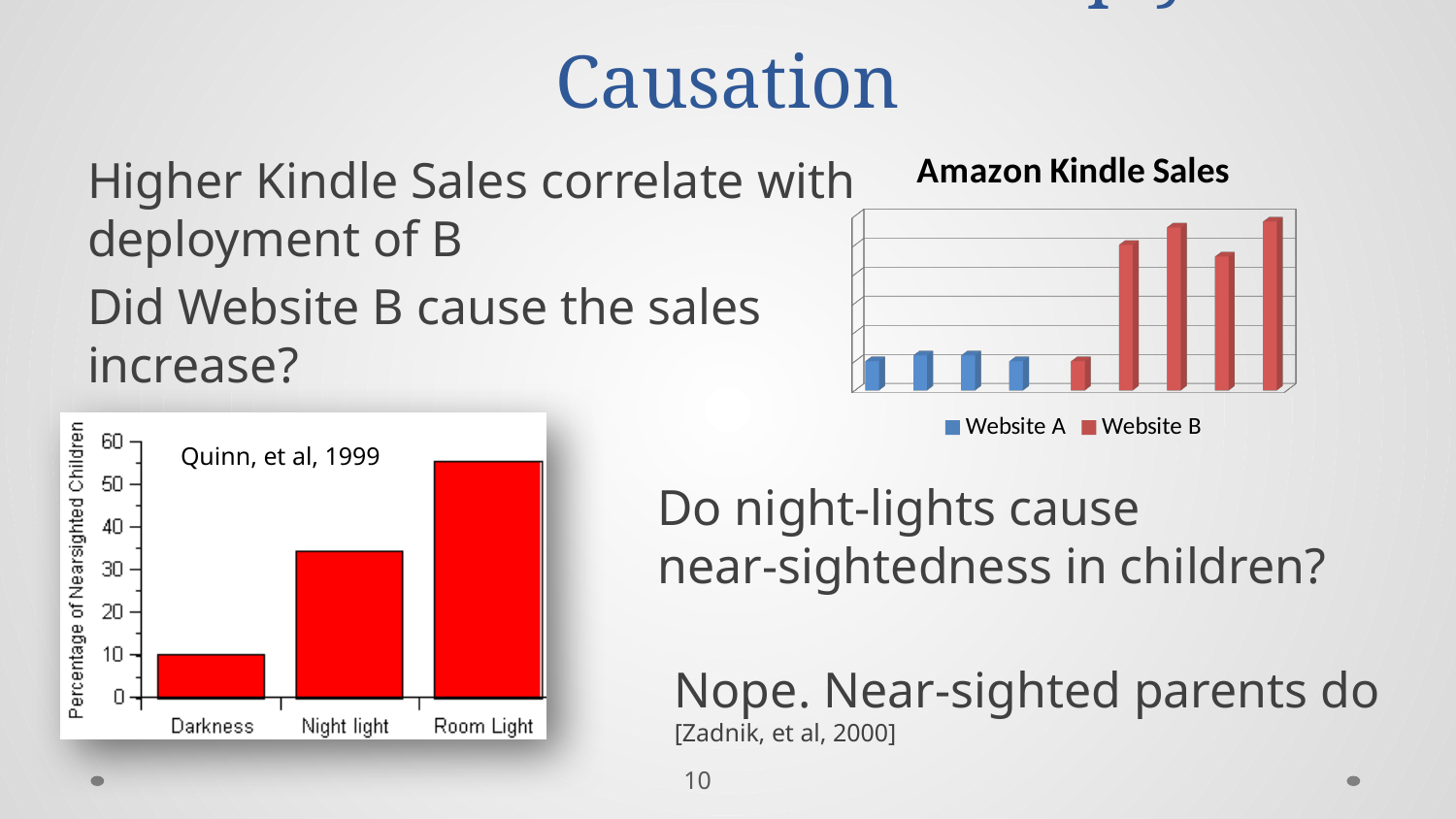
In the Quinn, et al, 1999 chart, do the values rise or fall from Darkness to Room Light? rise In the Quinn, et al, 1999 chart, which category has the highest percentage of nearsighted children? Room Light In the Quinn, et al, 1999 chart, is the value for Room Light greater or less than 50? greater In the Quinn, et al, 1999 chart, is the value for Night light greater or less than 30? greater In the Quinn, et al, 1999 chart, what is the label of the y axis? Percentage of Nearsighted Children In the Quinn, et al, 1999 chart, which category has the lowest percentage of nearsighted children? Darkness In the Amazon Kindle Sales chart, which series has the taller bars, Website A or Website B? Website B In the Quinn, et al, 1999 chart, how many categories are shown on the x axis? 3 In the Quinn, et al, 1999 chart, what is the percentage of nearsighted children for Darkness? 10 What kind of chart is the Amazon Kindle Sales chart? bar chart How many series does the legend of the Amazon Kindle Sales chart list? 2 In the Quinn, et al, 1999 chart, which is larger, the value for Night light or the value for Room Light? Room Light